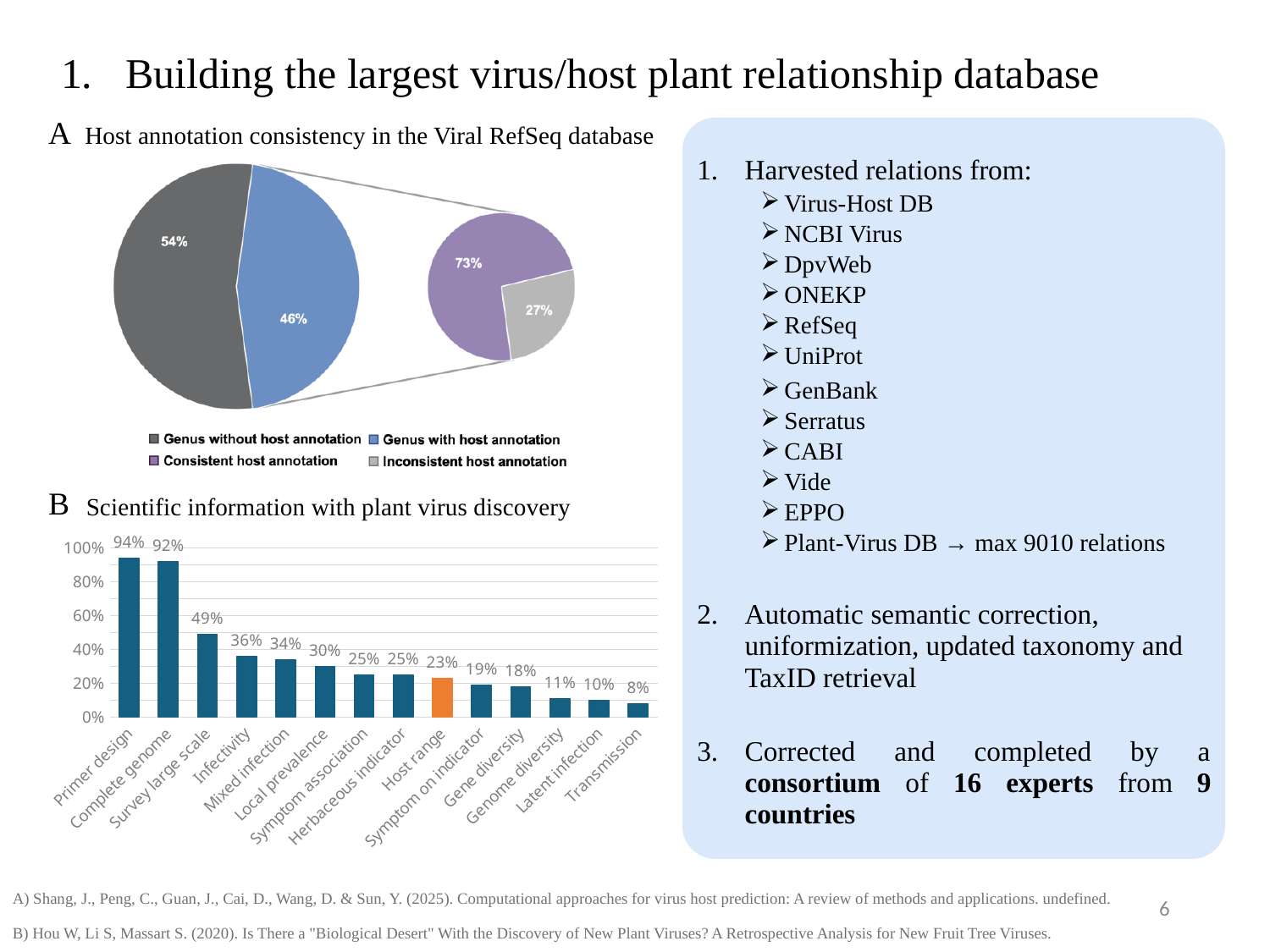
In chart B, which is larger, 'Survey large scale' or 'Infectivity'? Survey large scale In chart A, what percentage is labelled 'Genus with host annotation'? 46% In chart B, how many categories are plotted? 14 In chart B, what is the difference between 'Primer design' and 'Complete genome'? 2% In chart A, what kind of chart is used? Pie chart In chart B, which category has the highest value? Primer design In chart A (Host annotation consistency in the Viral RefSeq database), what share of the large pie is 'Genus without host annotation'? 54% In chart A, what is the difference between the 'Consistent host annotation' and 'Inconsistent host annotation' shares? 46% In chart A, what share of the smaller pie is 'Consistent host annotation'? 73% In chart B (Scientific information with plant virus discovery), what is the value for 'Host range'? 23% In chart B, do the values rise or fall from left to right along the x axis? Fall In chart B, which category has the lowest value? Transmission